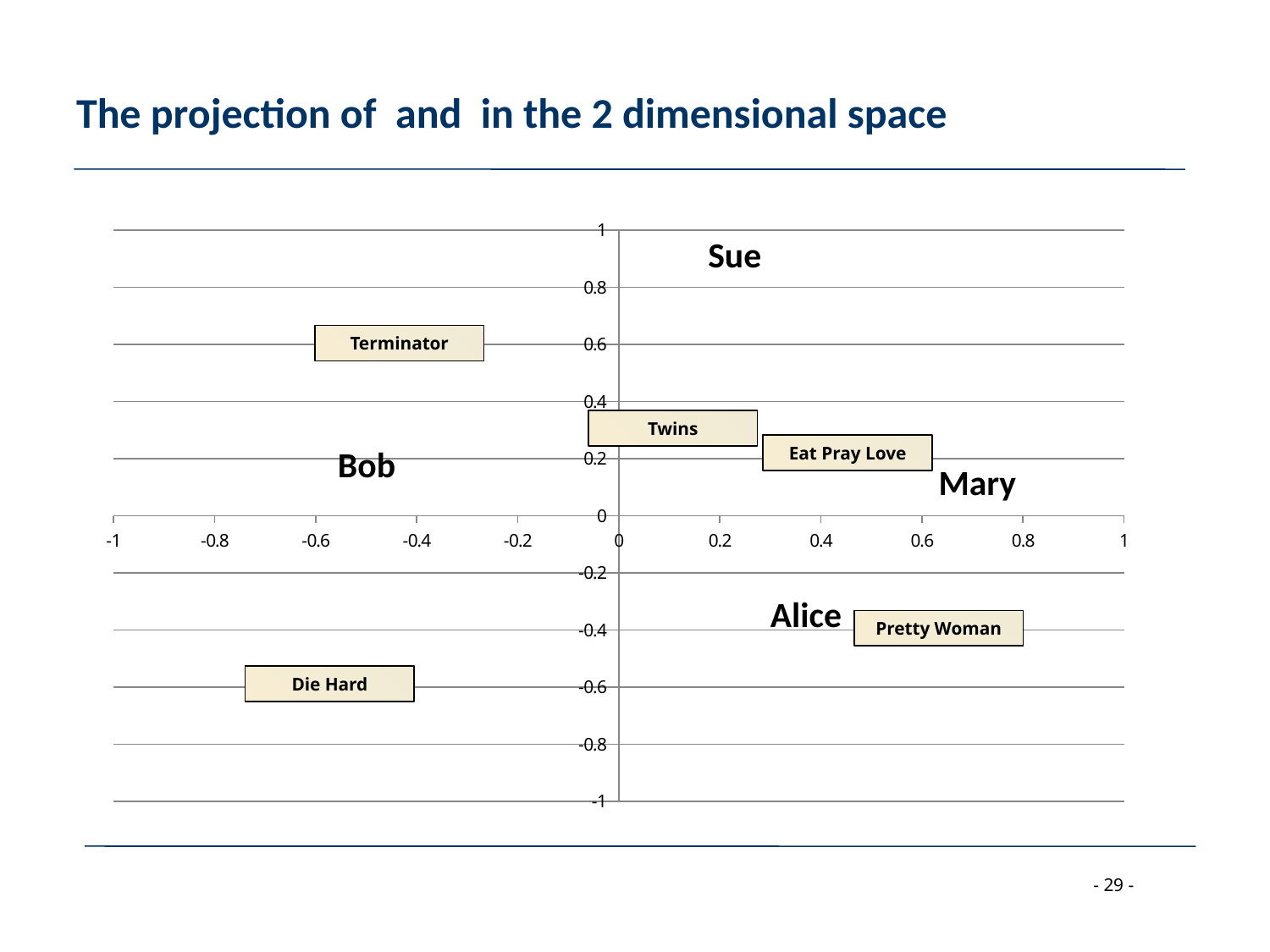
Which is plotted further to the right on the horizontal axis, Bob or Mary? Mary Is the horizontal-axis value for Die Hard greater or less than 0? less Is the vertical-axis value for Pretty Woman greater or less than 0? less Is the vertical-axis value for Terminator greater or less than 0.4? greater What kind of chart is shown on the slide? scatter chart How many movie labels (boxed labels) are plotted on the chart? 5 Which movie label is plotted highest on the vertical axis? Terminator How many person names (Sue, Bob, Mary, Alice) are plotted on the chart? 4 Which movie label is plotted lowest on the vertical axis? Die Hard What is the range of the horizontal axis shown on the chart? -1 to 1